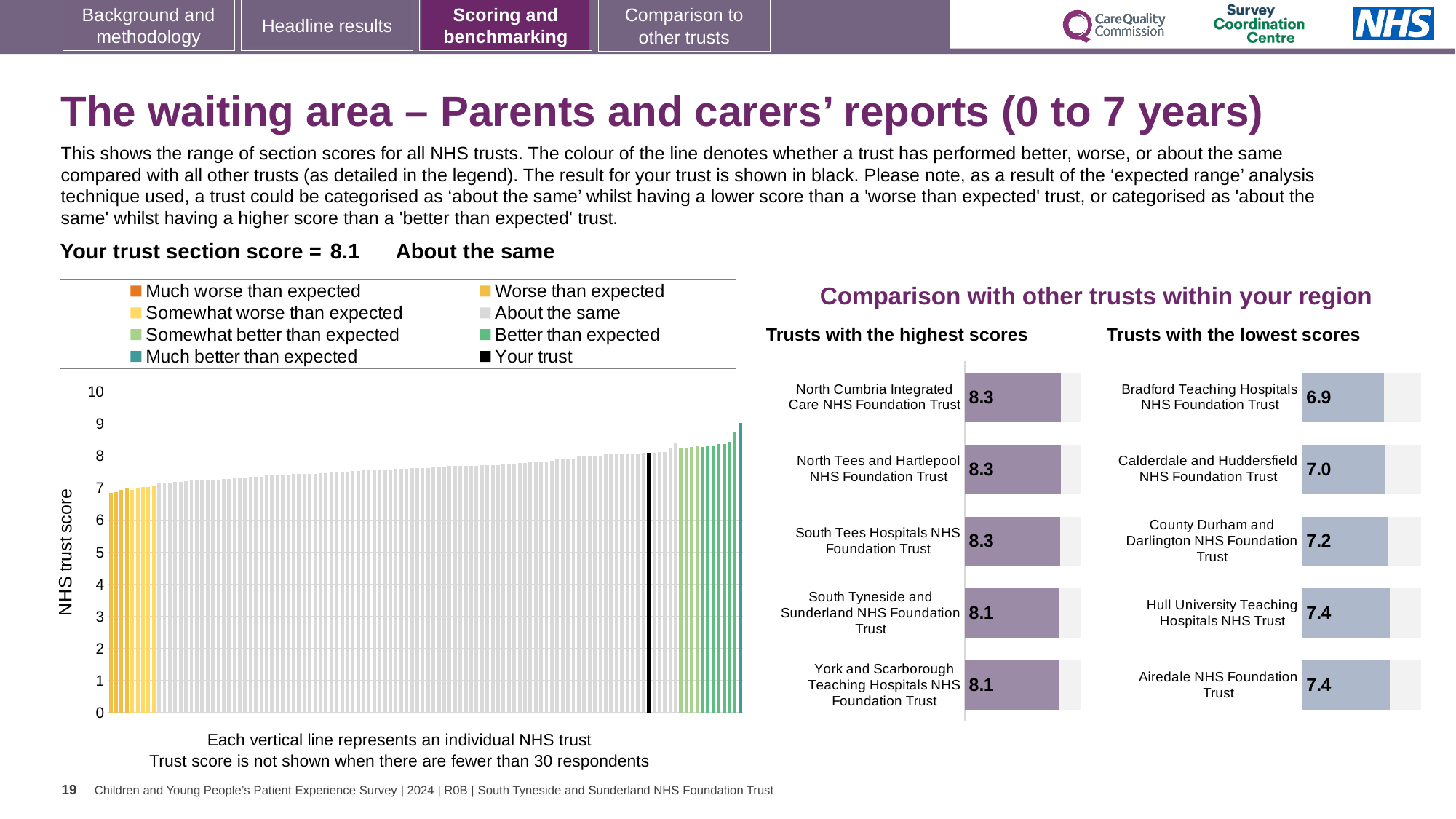
How many trusts are listed in the 'Trusts with the highest scores' chart? 5 In the 'Trusts with the lowest scores' chart, which has the higher score: Hull University Teaching Hospitals NHS Trust or Calderdale and Huddersfield NHS Foundation Trust? Hull University Teaching Hospitals NHS Trust In the 'Trusts with the highest scores' chart, what is the difference between the score for South Tees Hospitals NHS Foundation Trust and the score for York and Scarborough Teaching Hospitals NHS Foundation Trust? 0.2 In the 'Trusts with the lowest scores' chart, which trust has the lowest score? Bradford Teaching Hospitals NHS Foundation Trust What type of chart is the large chart on the left showing the range of section scores for all NHS trusts? Bar chart In the 'Trusts with the lowest scores' chart, what is the score for Bradford Teaching Hospitals NHS Foundation Trust? 6.9 In the 'Trusts with the lowest scores' chart, what is the difference between the score for Airedale NHS Foundation Trust and the score for Bradford Teaching Hospitals NHS Foundation Trust? 0.5 How many entries does the legend above the large chart on the left list? 8 In the 'Trusts with the lowest scores' chart, what is the score for County Durham and Darlington NHS Foundation Trust? 7.2 What is the label on the vertical axis of the large chart on the left? NHS trust score In the 'Trusts with the highest scores' chart, what is the score for North Cumbria Integrated Care NHS Foundation Trust? 8.3